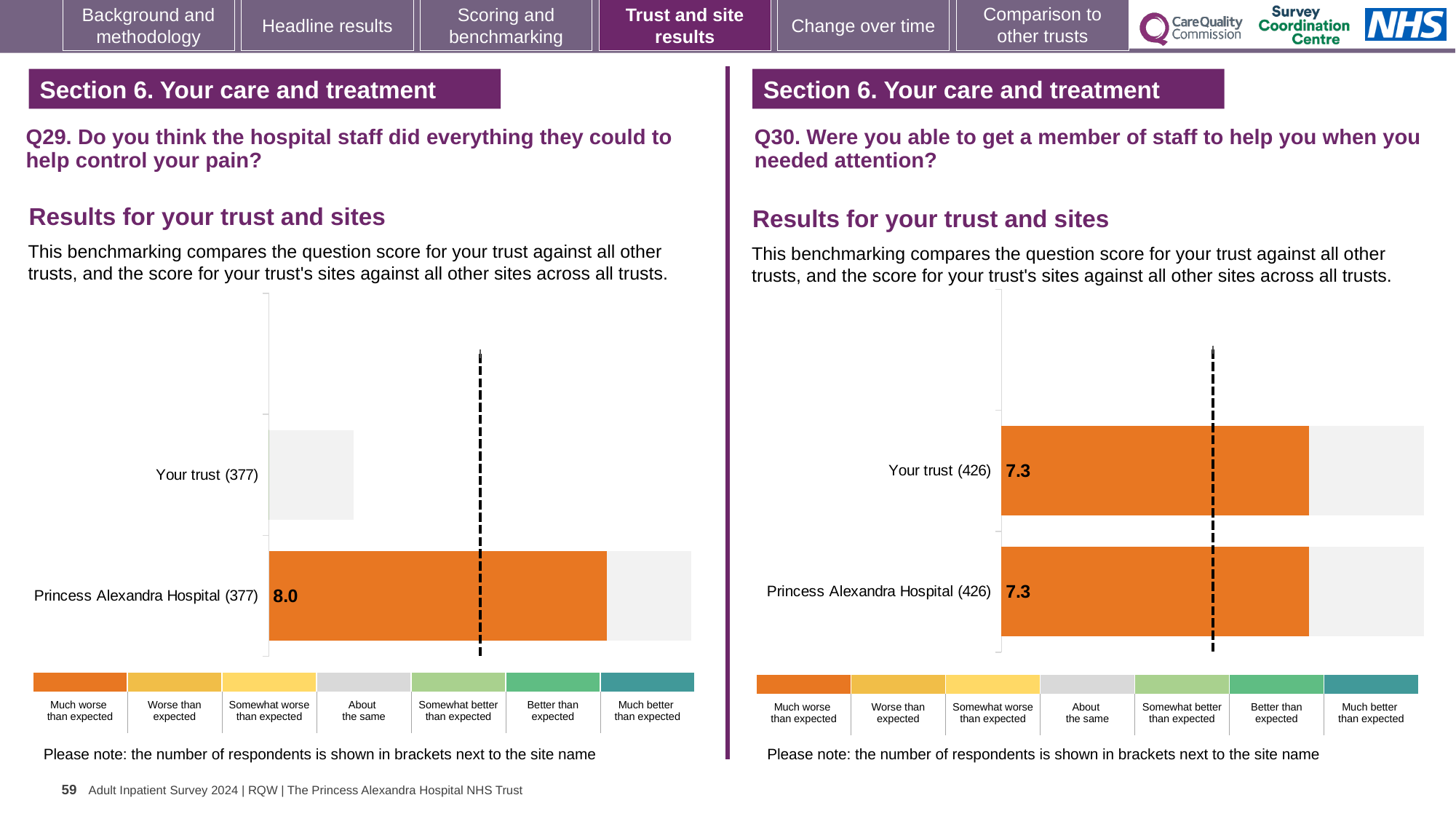
On the Q30 chart (right), how many respondents are shown in brackets for Your trust? 426 On the Q29 chart (left), what is the score shown for Princess Alexandra Hospital (377)? 8.0 What kind of chart is used on the Q29 chart (left)? Bar chart How many rows (categories) are labelled on the Q29 chart (left)? 2 On the Q29 chart (left), which row has a printed score label? Princess Alexandra Hospital (377) How many rows (categories) are plotted on the Q30 chart (right)? 2 On the Q30 chart (right), what is the score shown for Your trust (426)? 7.3 On the Q30 chart (right), what is the score shown for Princess Alexandra Hospital (426)? 7.3 According to the colour key below the Q29 chart (left), which rating category does the orange colour represent? Much worse than expected On the Q30 chart (right), what is the difference between the scores for Your trust (426) and Princess Alexandra Hospital (426)? 0.0 On the Q29 chart (left), how many respondents are shown in brackets for Princess Alexandra Hospital? 377 How many rating categories does the colour key below the Q30 chart (right) list? 7